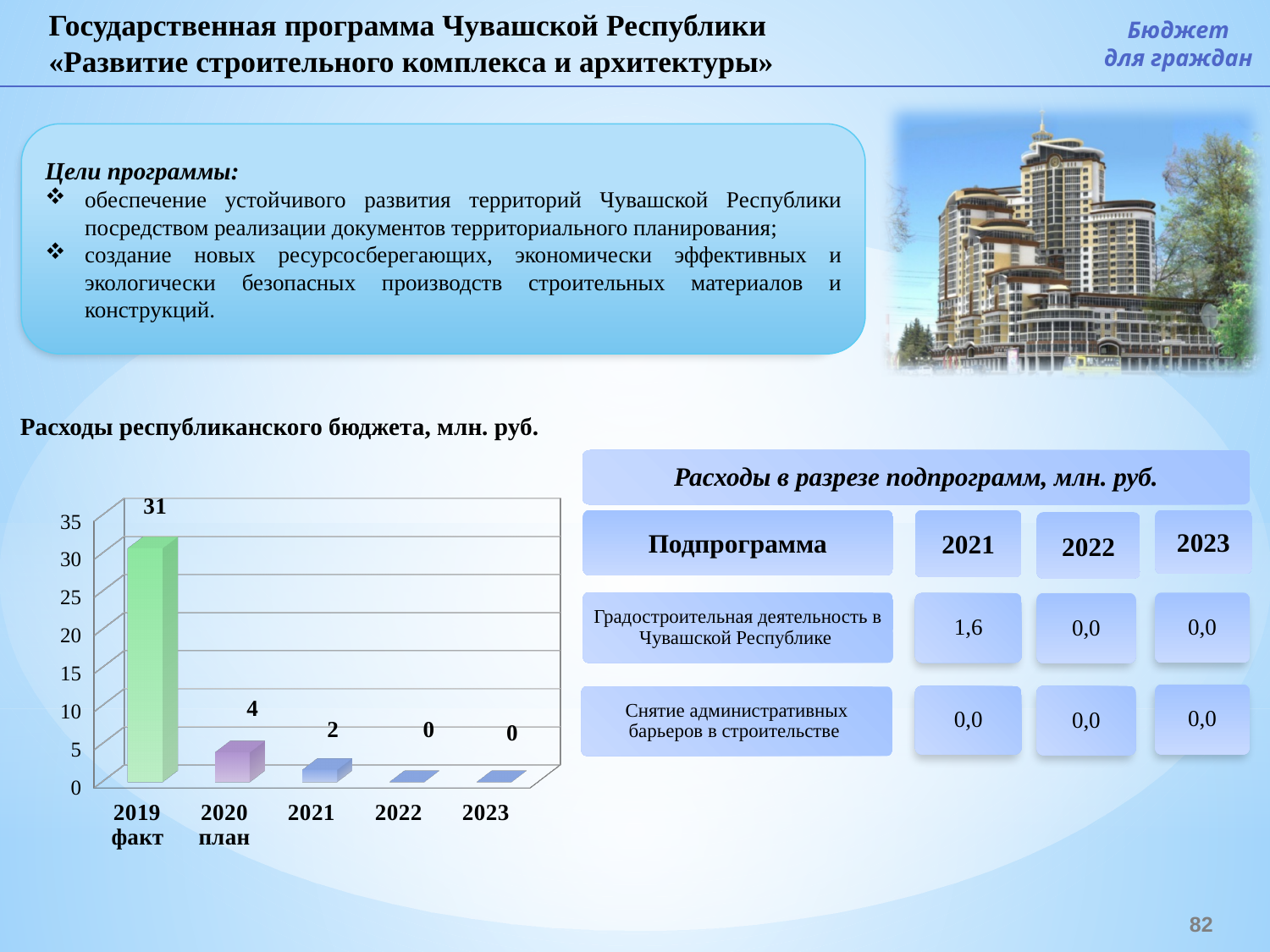
What is the value for 2023 in the chart? 0 What is the value for 2020 план in the chart? 4 Do the values rise or fall from 2019 факт to 2023 along the x axis? fall What kind of chart is shown on the slide? bar chart Which is larger, the value for 2020 план or the value for 2021? 2020 план What is the difference between the values for 2019 факт and 2020 план? 27 What is the value for 2019 факт in the chart 'Расходы республиканского бюджета, млн. руб.'? 31 Is the value for 2019 факт greater or less than 30? greater What is the value for 2021 in the chart? 2 How many categories are shown on the x axis of the chart? 5 What is the difference between the values for 2020 план and 2021? 2 Which category has the highest value in the chart? 2019 факт